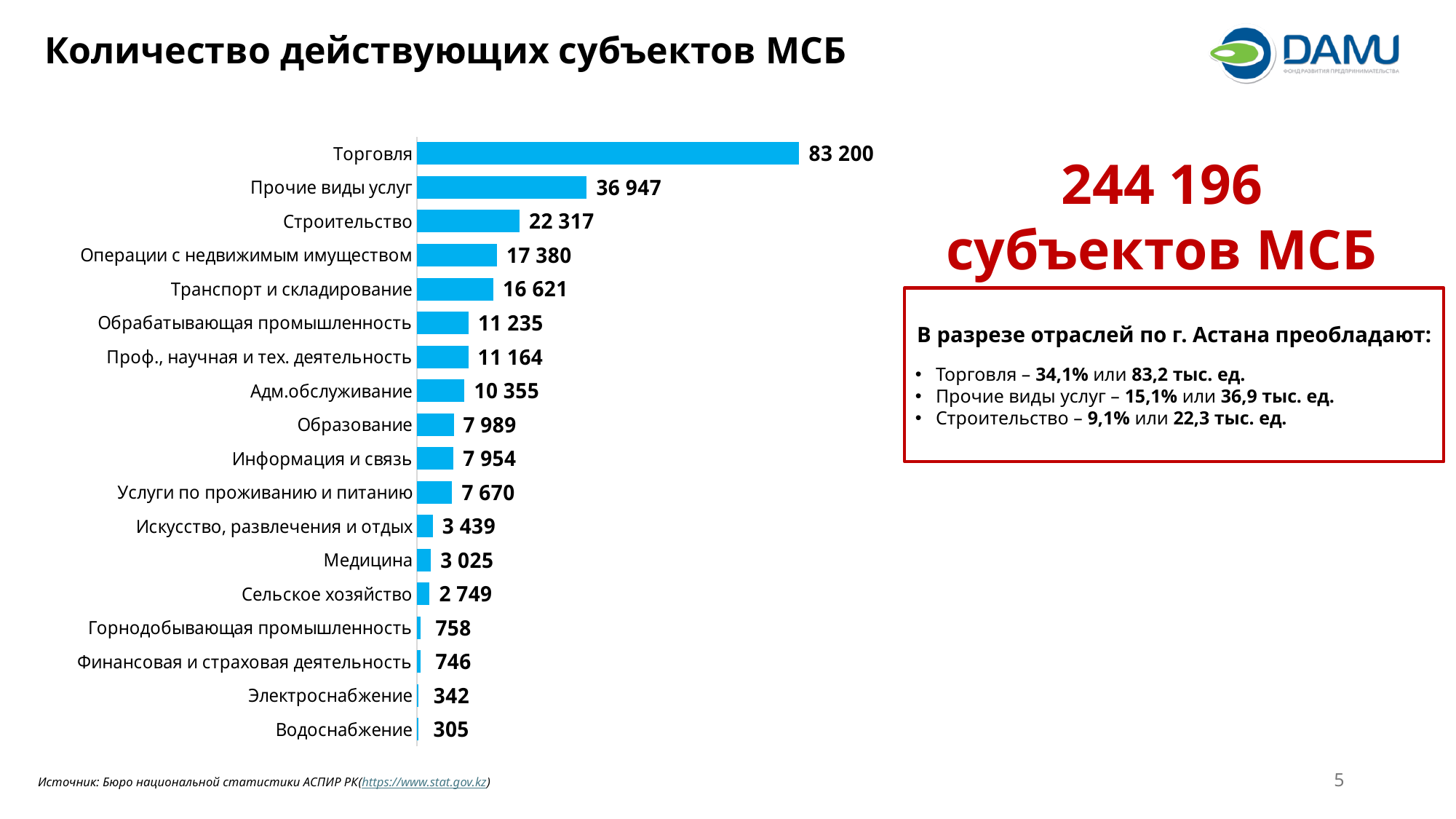
What is the value for Торговля? 83 200 Which category has the lowest value? Водоснабжение What is the value for Электроснабжение? 342 What is the difference between the values for Горнодобывающая промышленность and Финансовая и страховая деятельность? 12 What is the value for Транспорт и складирование? 16 621 Which category has the highest value? Торговля What is the value for Сельское хозяйство? 2 749 Which is larger, the value for Медицина or the value for Сельское хозяйство? Медицина What is the title of the slide containing the chart? Количество действующих субъектов МСБ What kind of chart is shown on the slide? Bar chart How many categories are shown in the chart? 18 What is the difference between the values for Торговля and Прочие виды услуг? 46 253